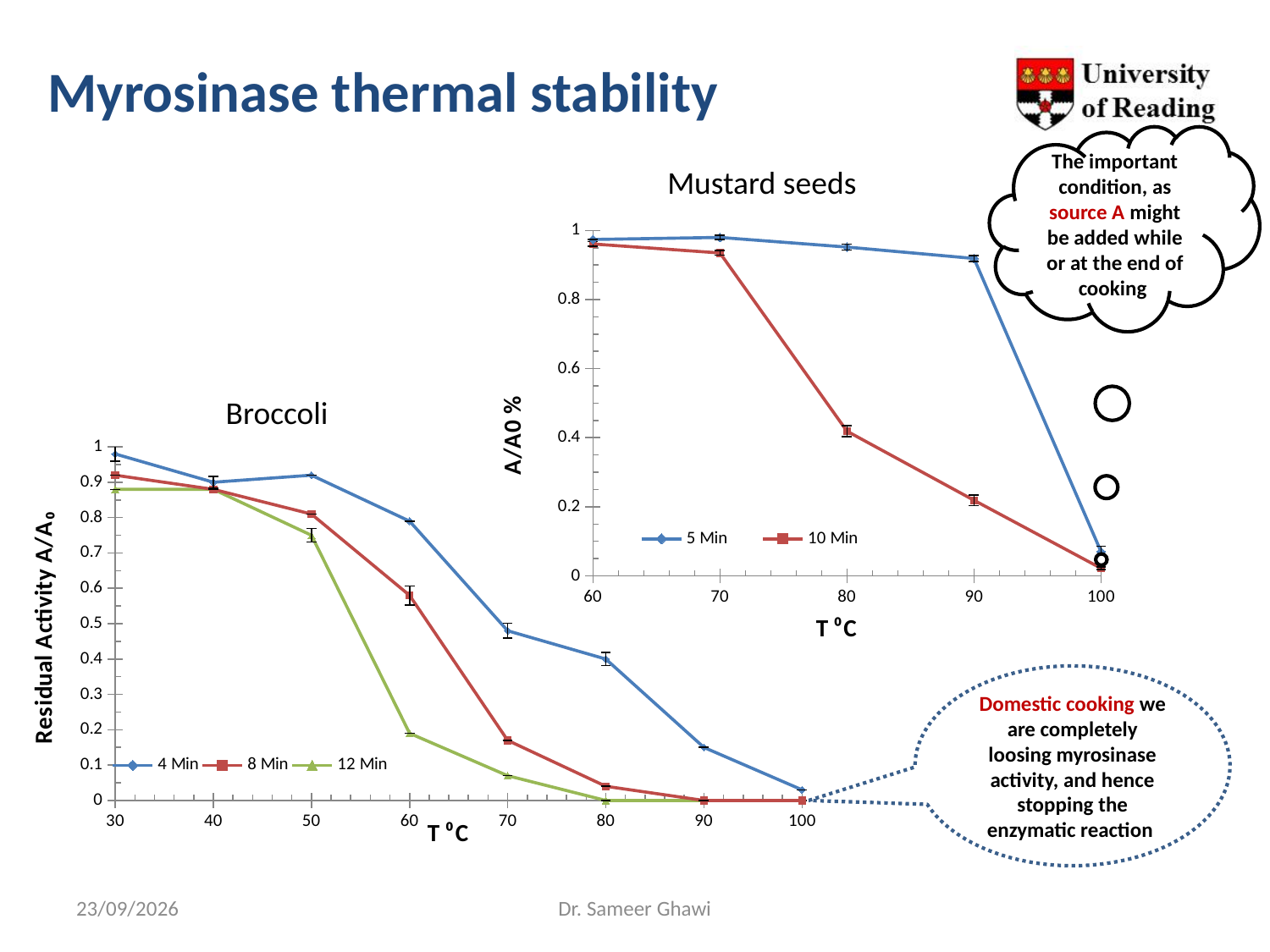
How many series does the legend of the Mustard seeds chart list? 2 In the Mustard seeds chart, do the values of the 10 Min series rise or fall as temperature increases? fall What is the y-axis label of the Broccoli chart? Residual Activity A/A₀ How many temperature points are plotted along the x axis of the Mustard seeds chart? 5 In the Broccoli chart, is the 4 Min value at 60 °C greater or less than 0.6? greater What type of chart is the Broccoli chart? line chart In the Broccoli chart, is the 12 Min value at 60 °C greater or less than 0.4? less In the Mustard seeds chart, is the 5 Min value at 90 °C greater or less than 0.8? greater How many series does the legend of the Broccoli chart list? 3 How many temperature points are plotted along the x axis of the Broccoli chart? 8 In the Broccoli chart, which series has the larger value at 60 °C, 4 Min or 12 Min? 4 Min